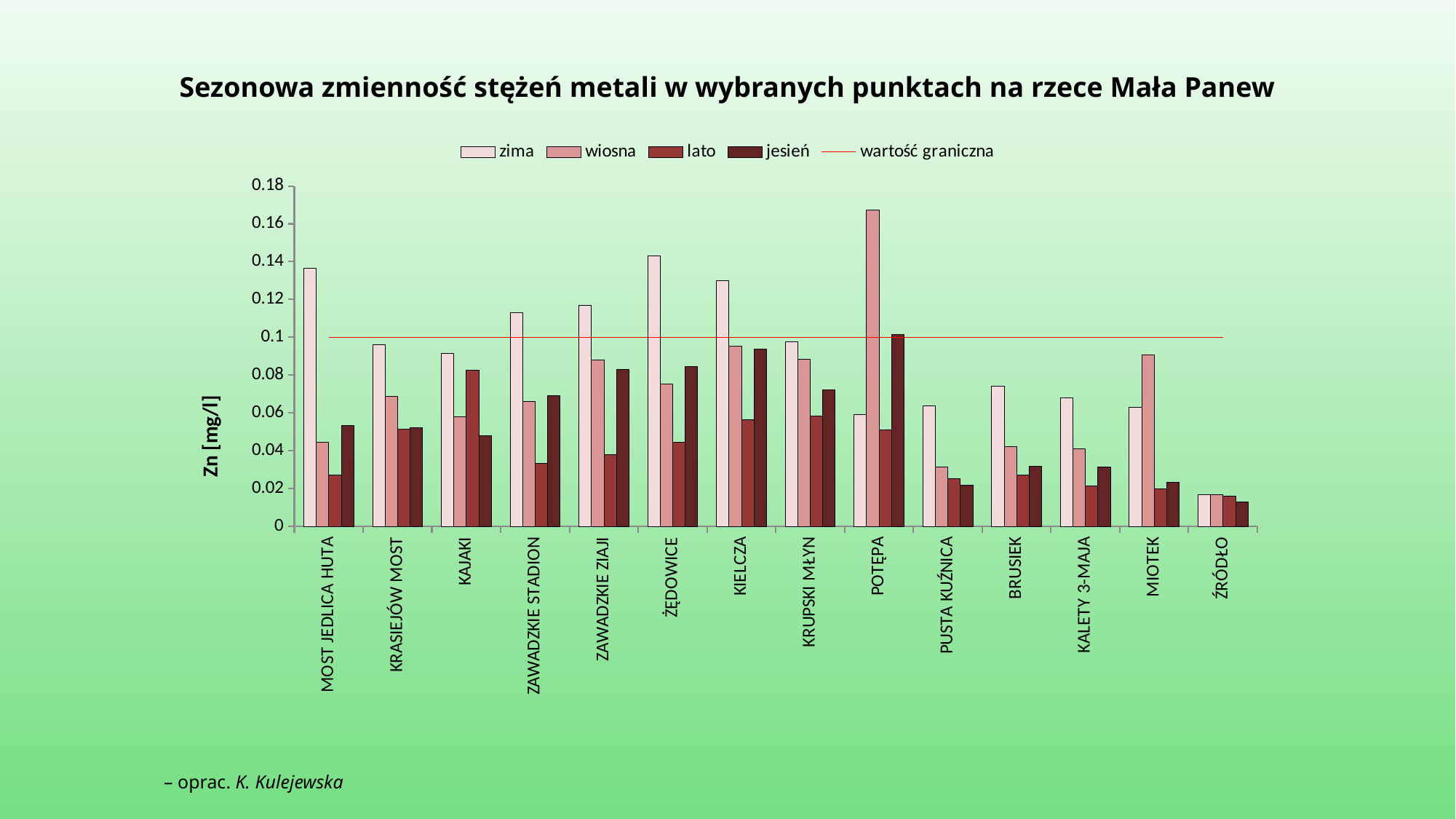
Is the zima value for MOST JEDLICA HUTA greater or less than 0.12? greater What is the label of the y axis? Zn [mg/l] At ŻĘDOWICE, which is larger: the zima value or the lato value? zima What kind of chart is shown on the slide? bar chart At MIOTEK, which is larger: the zima value or the wiosna value? wiosna Which sampling point has the lowest values across all four seasons? ŹRÓDŁO Is the lato value for ZAWADZKIE STADION greater or less than 0.04? less How many sampling points (categories) are shown on the x axis? 14 How many entries does the legend list? 5 At which sampling point does the wiosna series reach its highest value? POTĘPA Is the wiosna value for POTĘPA greater or less than 0.16? greater Which legend entry is drawn as a horizontal line rather than bars? wartość graniczna